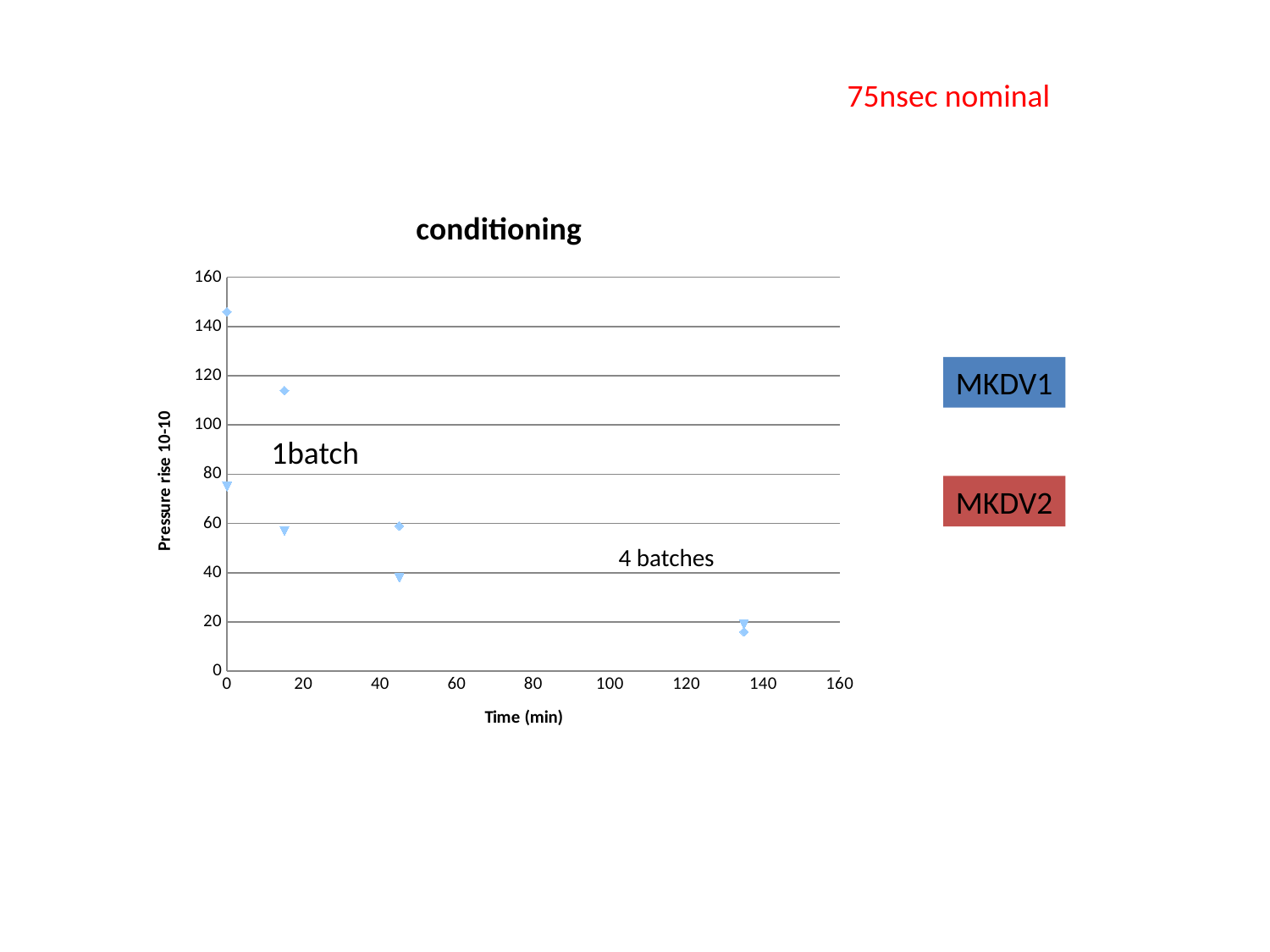
At time 0, which series has the larger value, the diamond-marker series or the triangle-marker series? the diamond-marker series How many data points does the triangle-marker series have? 4 What kind of chart is shown on the slide? scatter chart Is the value of the diamond-marker series at time 0 greater or less than 140? greater What is the label of the x axis of the chart? Time (min) How many data points does the diamond-marker series have? 4 Do the values of the diamond-marker series rise or fall as time increases? fall Do the values of the triangle-marker series rise or fall as time increases? fall Is the value of the diamond-marker series at time 15 greater or less than 100? greater Is the value of the triangle-marker series at time 45 greater or less than 60? less What is the title of the chart? conditioning